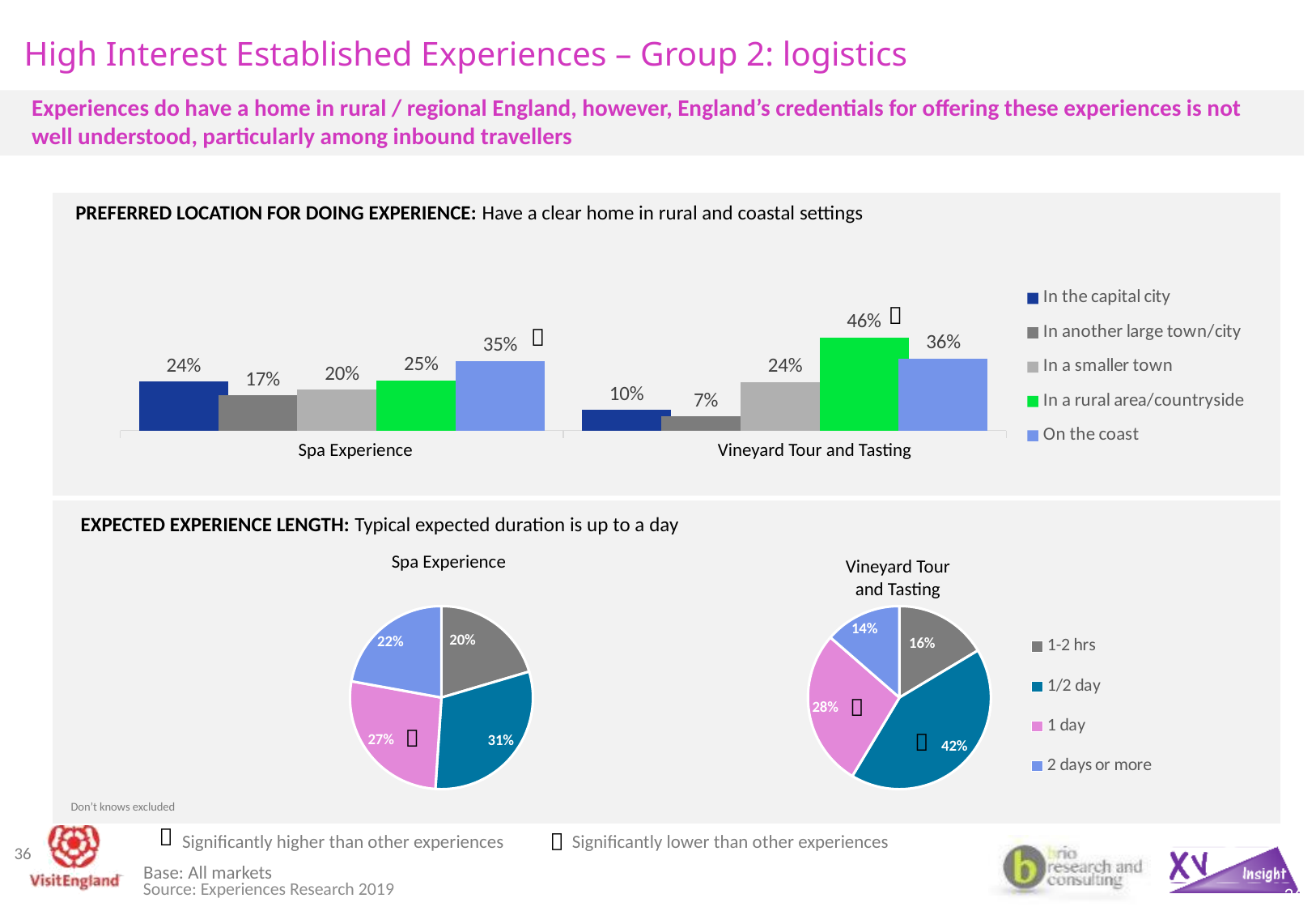
In the Preferred Location bar chart, what percentage of respondents chose 'In a rural area/countryside' for Vineyard Tour and Tasting? 46% In the Preferred Location bar chart, which location has the highest value for Spa Experience? On the coast In the Vineyard Tour and Tasting pie chart, which duration has the largest slice? 1/2 day In the Preferred Location bar chart, what is the difference between 'In the capital city' for Spa Experience and for Vineyard Tour and Tasting? 14 percentage points What kind of chart is used for Preferred Location for Doing Experience? Bar chart In the Preferred Location bar chart, what is the value for 'On the coast' for Spa Experience? 35% In the Preferred Location bar chart, which location has the lowest value for Vineyard Tour and Tasting? In another large town/city In the Preferred Location bar chart, which is larger: 'In a smaller town' for Spa Experience or for Vineyard Tour and Tasting? Vineyard Tour and Tasting In the Spa Experience pie chart, what share is '1/2 day'? 31% How many series does the legend of the Preferred Location bar chart list? 5 In the Vineyard Tour and Tasting pie chart, what is the value for '2 days or more'? 14% How many slices does the Spa Experience pie chart have? 4